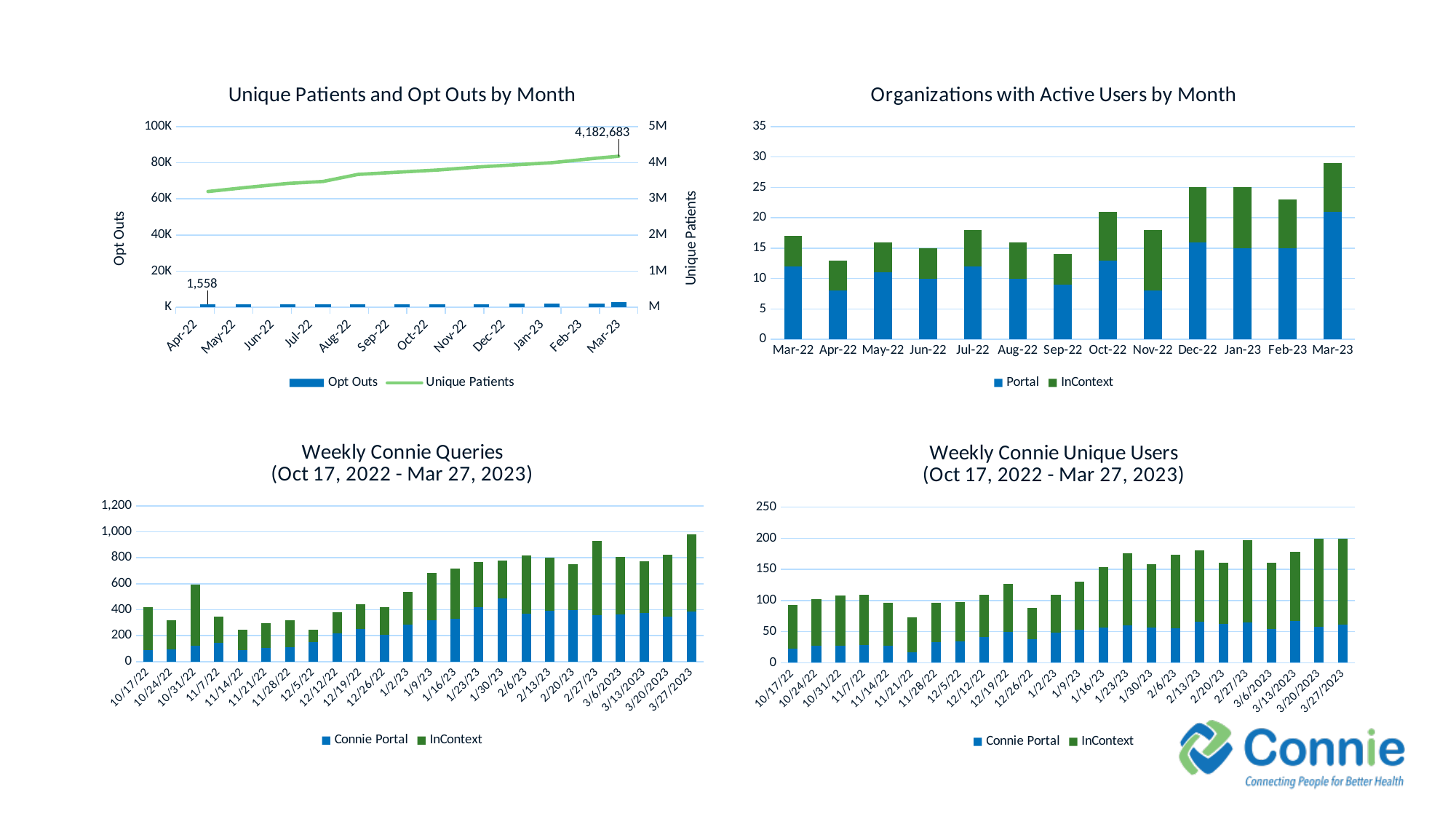
In the 'Weekly Connie Unique Users' chart, which week has the lowest total? 11/21/22 In the 'Unique Patients and Opt Outs by Month' chart, what is the Opt Outs value labelled for Apr-22? 1,558 How many series does the legend of the 'Unique Patients and Opt Outs by Month' chart list? 2 In the 'Unique Patients and Opt Outs by Month' chart, what is the Unique Patients value labelled for Mar-23? 4,182,683 In the 'Organizations with Active Users by Month' chart, is the total for Mar-23 greater or less than 25? greater What kind of chart is the 'Weekly Connie Queries' chart? stacked bar chart How many months are shown on the x axis of the 'Organizations with Active Users by Month' chart? 13 In the 'Weekly Connie Unique Users' chart, do the totals generally rise or fall from Oct 2022 to Mar 2023? rise In the 'Weekly Connie Queries' chart, which week has the highest total? 3/27/2023 In the 'Organizations with Active Users by Month' chart, which month has the highest total? Mar-23 In the 'Organizations with Active Users by Month' chart, is the total for Apr-22 greater or less than 15? less How many weeks are shown on the x axis of the 'Weekly Connie Unique Users' chart? 24